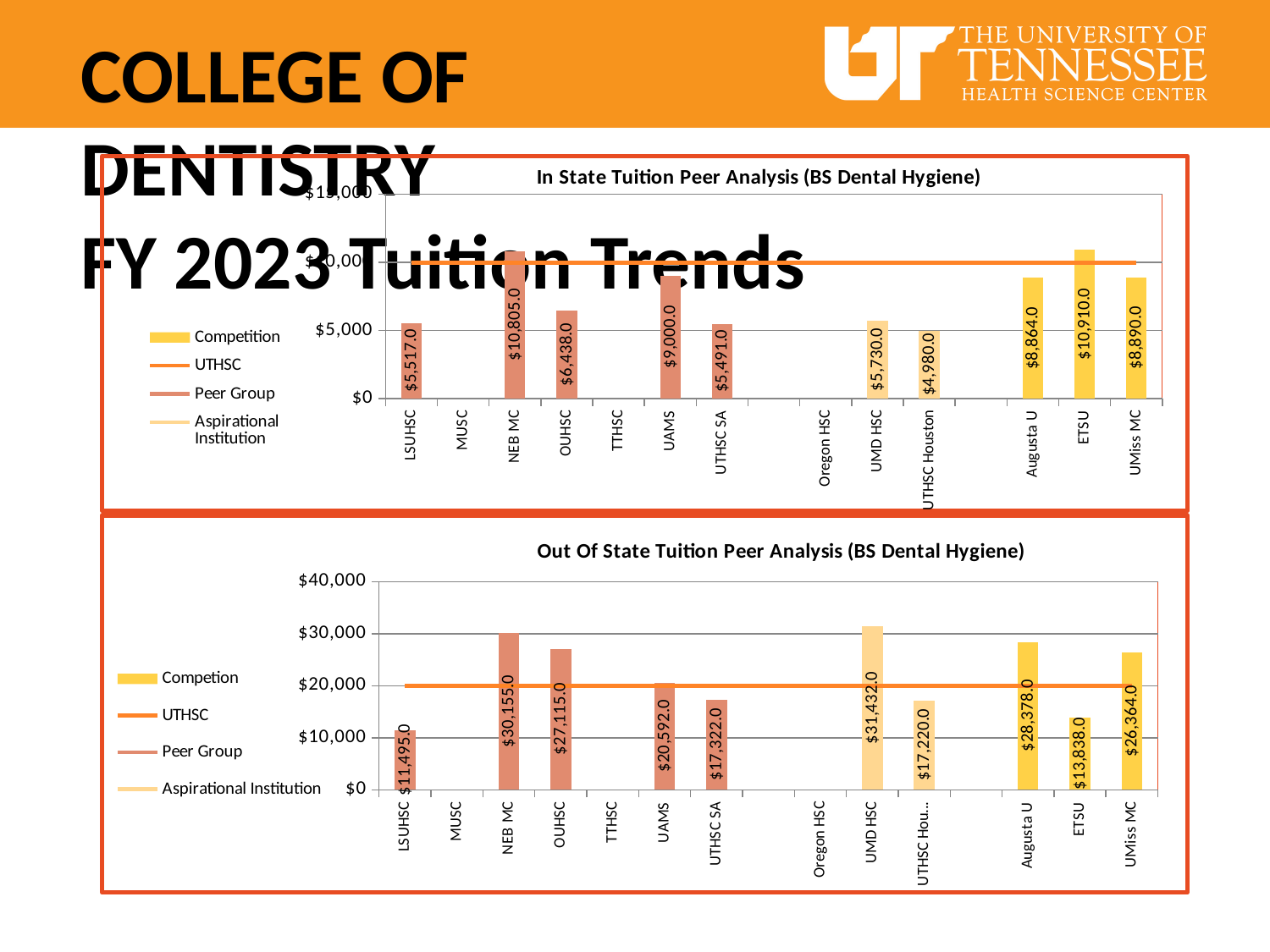
In the In State Tuition Peer Analysis chart, which institution has the highest labeled tuition? ETSU In the In State Tuition Peer Analysis chart, what is the difference between ETSU and NEB MC? $105.0 In the Out Of State Tuition Peer Analysis chart, what is the value for UMD HSC? $31,432.0 In the In State Tuition Peer Analysis chart, what is the value for NEB MC? $10,805.0 In the Out Of State Tuition Peer Analysis chart, which is larger, NEB MC or OUHSC? NEB MC In the In State Tuition Peer Analysis chart, which institution has the lowest labeled tuition? UTHSC Houston In the Out Of State Tuition Peer Analysis chart, which institution has the lowest labeled tuition? LSUHSC What type of chart is the In State Tuition Peer Analysis chart? Bar chart In the In State Tuition Peer Analysis chart, is the value for UAMS greater or less than $5,000? greater How many entries does the legend of the Out Of State Tuition Peer Analysis chart list? 4 In the Out Of State Tuition Peer Analysis chart, is the value for ETSU greater or less than $20,000? less In the Out Of State Tuition Peer Analysis chart, what is the difference between NEB MC and OUHSC? $3,040.0